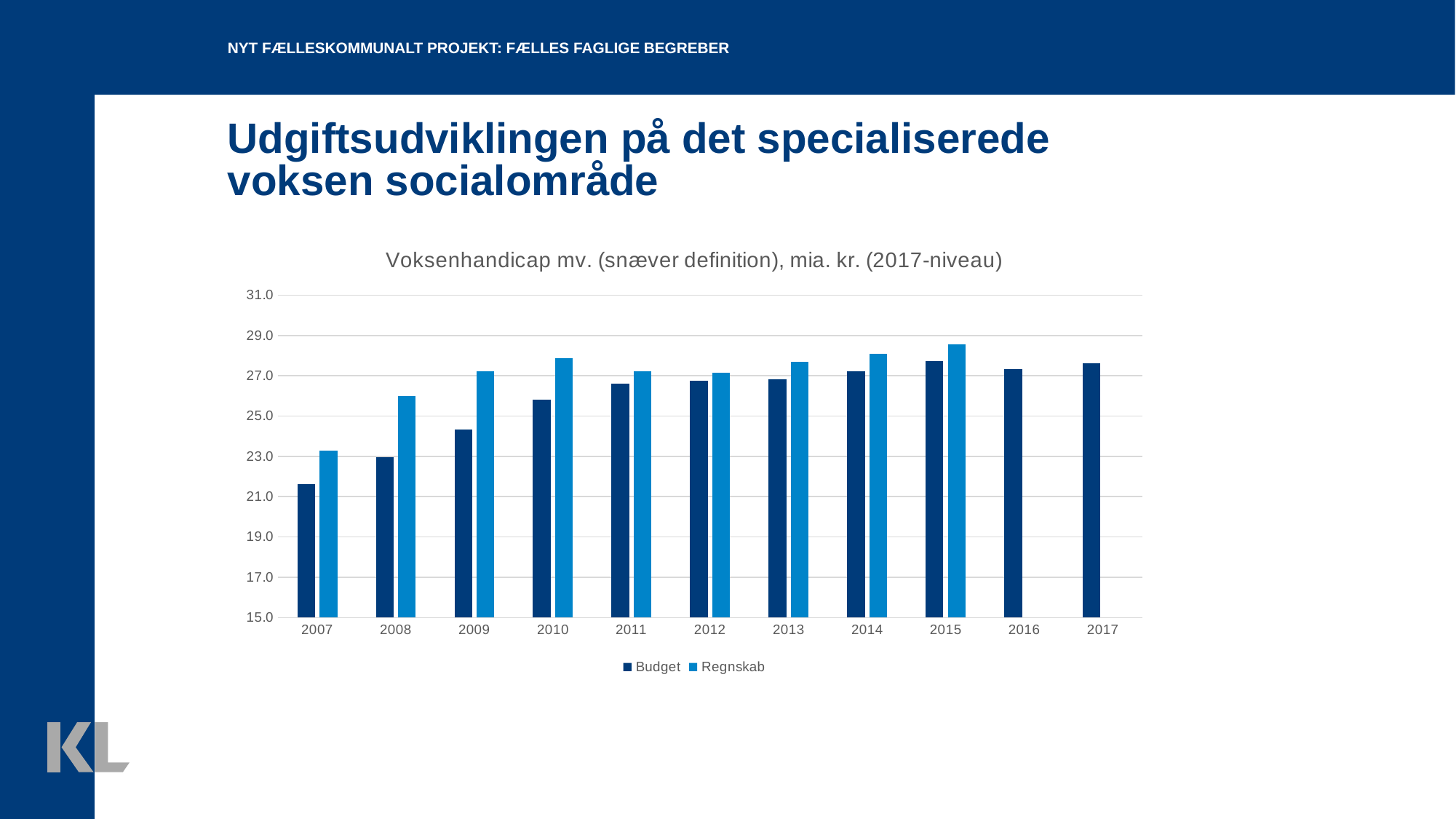
Which years have no Regnskab bar? 2016 and 2017 Do the Budget values generally rise or fall from 2007 to 2015? rise How many series does the legend list? 2 Is the Regnskab value for 2008 greater or less than 25.0? greater Is the Budget value for 2007 greater or less than 23.0? less How many years are shown on the x axis? 11 What kind of chart is shown on the slide? bar chart Which year has the lowest Budget value? 2007 Which year has the highest Regnskab value? 2015 In 2009, which is larger: Budget or Regnskab? Regnskab Is the Regnskab value for 2015 greater or less than 27.0? greater Which year has the lowest Regnskab value? 2007